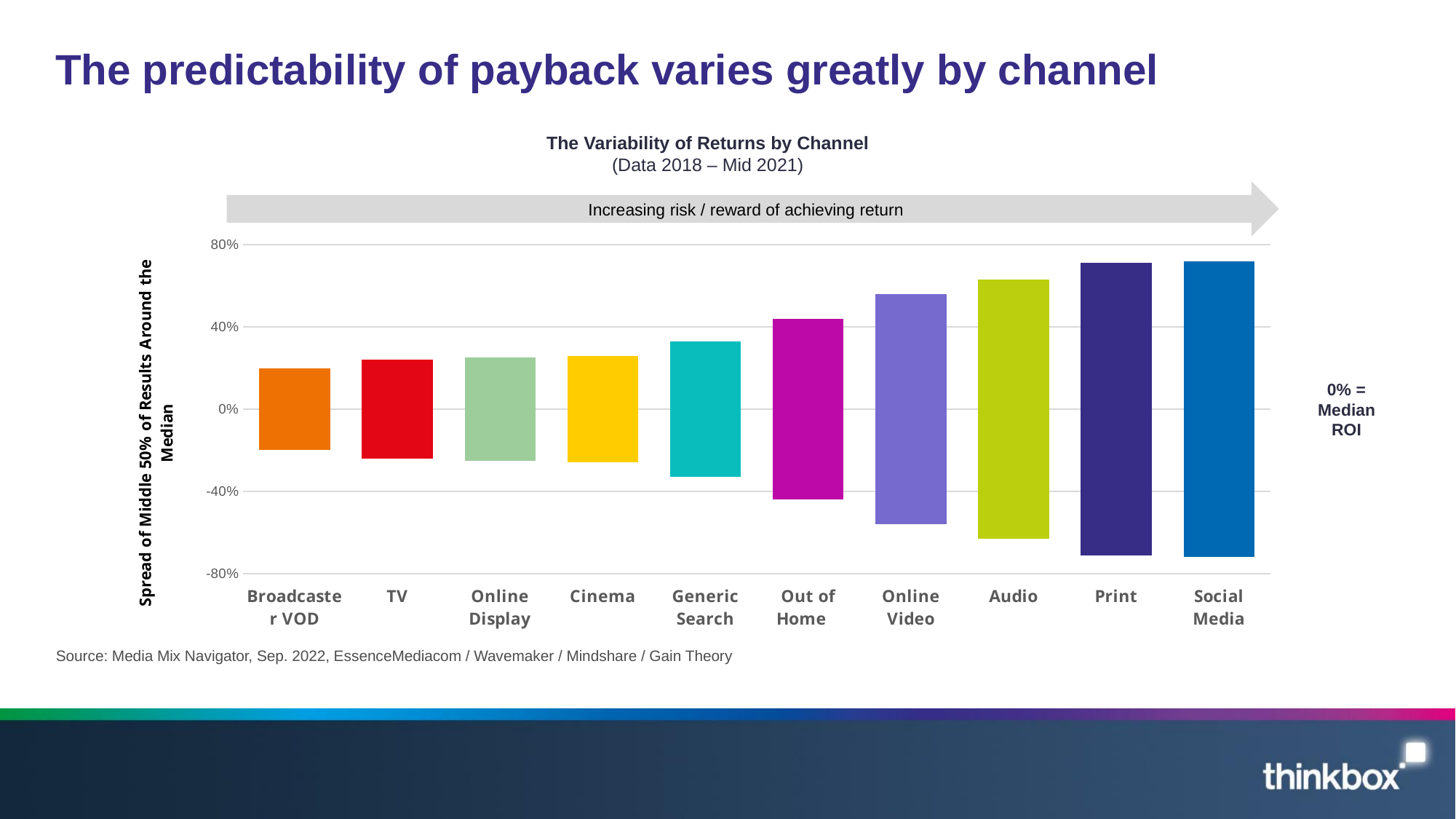
How many channels are shown on the x axis of the chart? 10 Does the spread of results increase or decrease moving from left to right along the x axis? Increase What is the title of the chart? The Variability of Returns by Channel What kind of chart is shown on the slide? Bar chart What data period is given in the chart subtitle? Data 2018 – Mid 2021 Is the lower end of the Print bar greater or less than -40%? less Is the upper end of the TV bar greater or less than 40%? less Which channel has a wider spread of results, Generic Search or Online Video? Online Video Is the upper end of the Online Video bar greater or less than 40%? greater Which channel has the narrowest spread of results around the median? Broadcaster VOD Which channel has a wider spread of results, Audio or Cinema? Audio